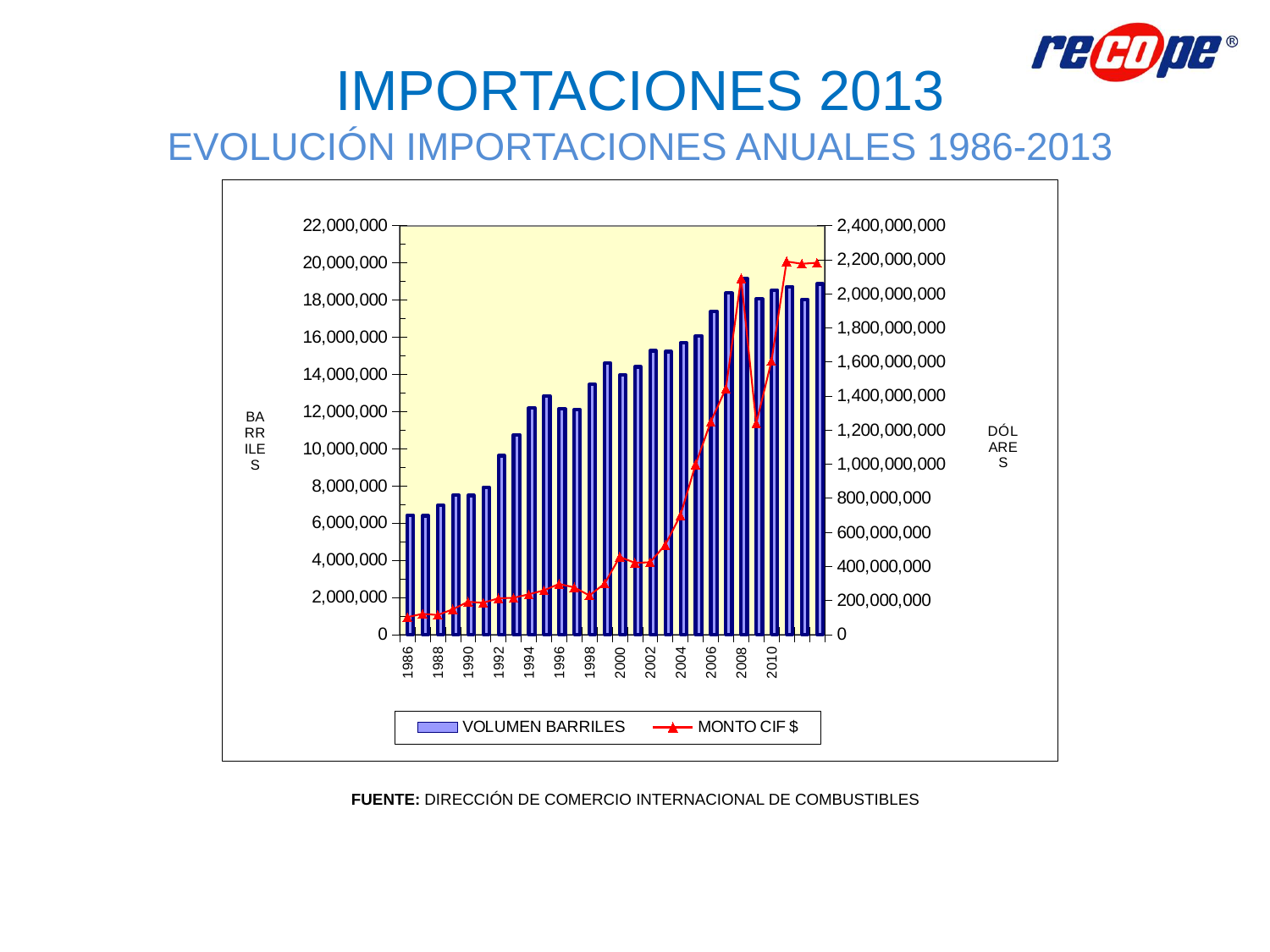
What are the two series named in the chart legend? VOLUMEN BARRILES and MONTO CIF $ How many years (bars) are plotted in the chart? 28 Which year has the larger VOLUMEN BARRILES value, 2000 or 2006? 2006 Is the MONTO CIF $ value for 2009 greater or less than 1,400,000,000? less How many series does the chart legend list? 2 Is the VOLUMEN BARRILES value for 1986 greater or less than 8,000,000? less Is the VOLUMEN BARRILES value for 2013 greater or less than 18,000,000? greater Which series is drawn as bars in the chart? VOLUMEN BARRILES What kind of chart is shown on the slide? Combined bar and line chart Which year has the larger MONTO CIF $ value, 2008 or 2009? 2008 Does the VOLUMEN BARRILES series generally rise or fall from 1986 to 2013? rise